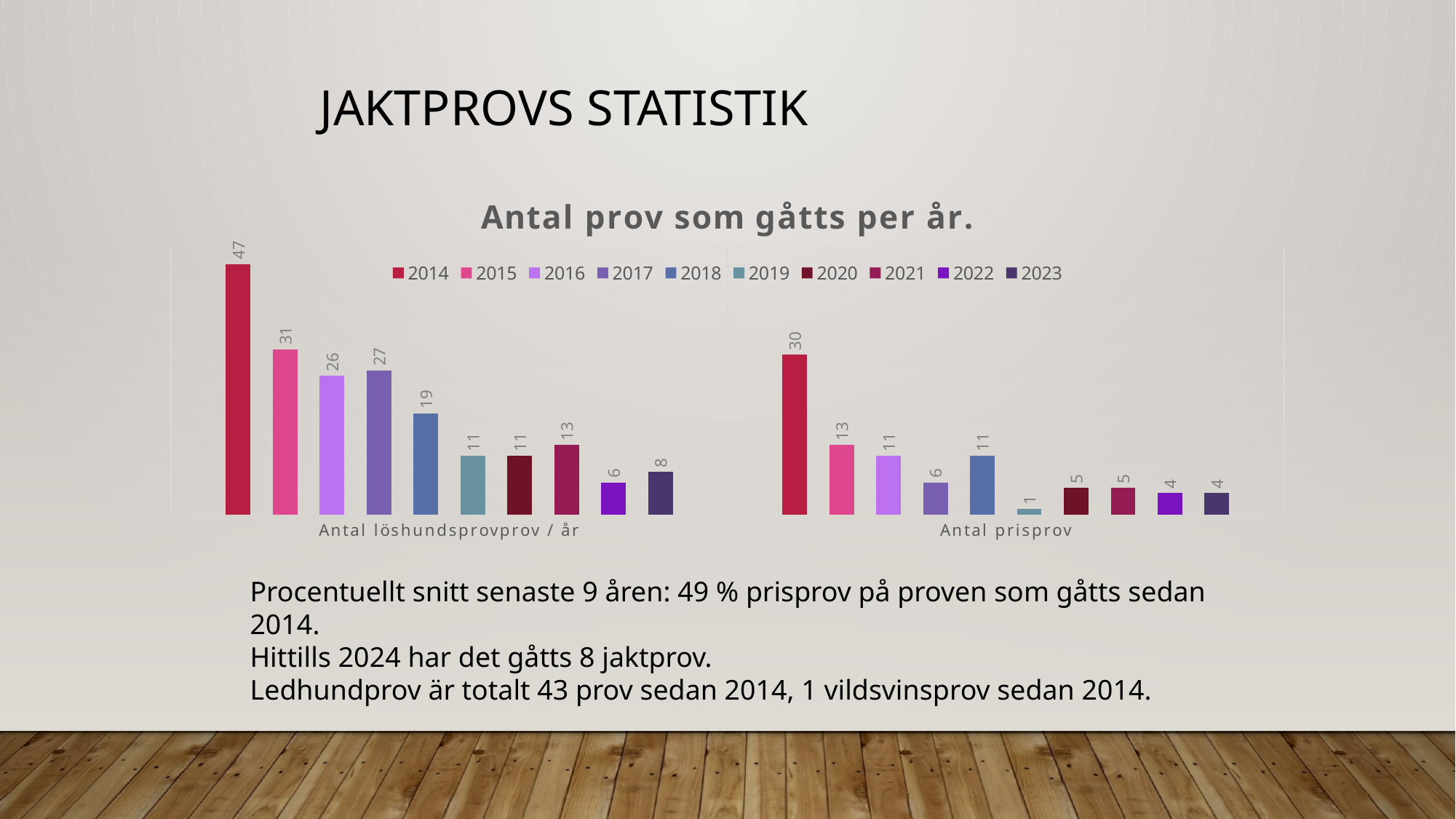
What is the value for 2019 in the "Antal prisprov" category? 1 What is the difference between the 2014 and 2015 values in the "Antal löshundsprovprov / år" category? 16 What is the value for 2014 in the "Antal löshundsprovprov / år" category? 47 Which year has the highest value in the "Antal prisprov" category? 2014 How many categories are shown on the x axis? 2 Which is larger in the "Antal löshundsprovprov / år" category: the value for 2016 or the value for 2017? 2017 What is the difference between the 2014 values for "Antal löshundsprovprov / år" and "Antal prisprov"? 17 What is the value for 2018 in the "Antal löshundsprovprov / år" category? 19 What kind of chart is shown on the slide? Bar chart How many series does the legend list? 10 Which year has the lowest value in the "Antal löshundsprovprov / år" category? 2022 What is the title of the chart? Antal prov som gåtts per år.